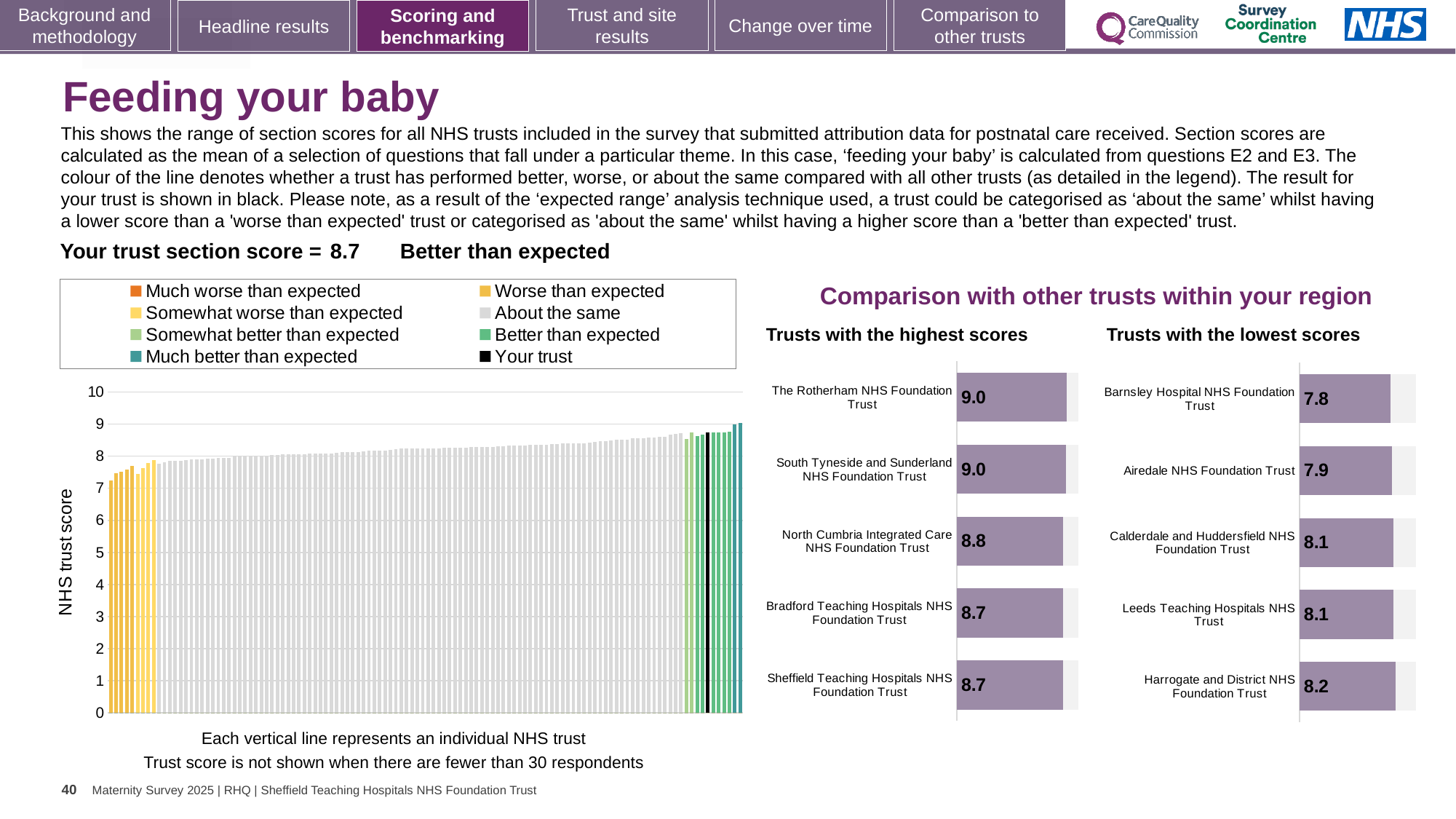
In the 'Trusts with the highest scores' chart, what is the score for The Rotherham NHS Foundation Trust? 9.0 In the 'Trusts with the lowest scores' chart, how many trusts are shown? 5 In the large 'NHS trust score' chart on the left, do the bar values rise or fall from left to right? rise In the 'Trusts with the lowest scores' chart, which trust has the lowest score? Barnsley Hospital NHS Foundation Trust How many entries does the legend above the large 'NHS trust score' chart list? 8 In the 'Trusts with the highest scores' chart, what is the score for North Cumbria Integrated Care NHS Foundation Trust? 8.8 In the 'Trusts with the lowest scores' chart, what is the score for Barnsley Hospital NHS Foundation Trust? 7.8 In the 'Trusts with the lowest scores' chart, what is the difference between the scores of Harrogate and District NHS Foundation Trust and Barnsley Hospital NHS Foundation Trust? 0.4 In the large 'NHS trust score' chart on the left, is the value for the black bar (your trust) greater or less than 8? greater In the 'Trusts with the highest scores' chart, which has the larger score: North Cumbria Integrated Care NHS Foundation Trust or Bradford Teaching Hospitals NHS Foundation Trust? North Cumbria Integrated Care NHS Foundation Trust In the 'Trusts with the highest scores' chart, what is the difference between the scores of The Rotherham NHS Foundation Trust and Sheffield Teaching Hospitals NHS Foundation Trust? 0.3 In the 'Trusts with the lowest scores' chart, which trust has the highest score? Harrogate and District NHS Foundation Trust